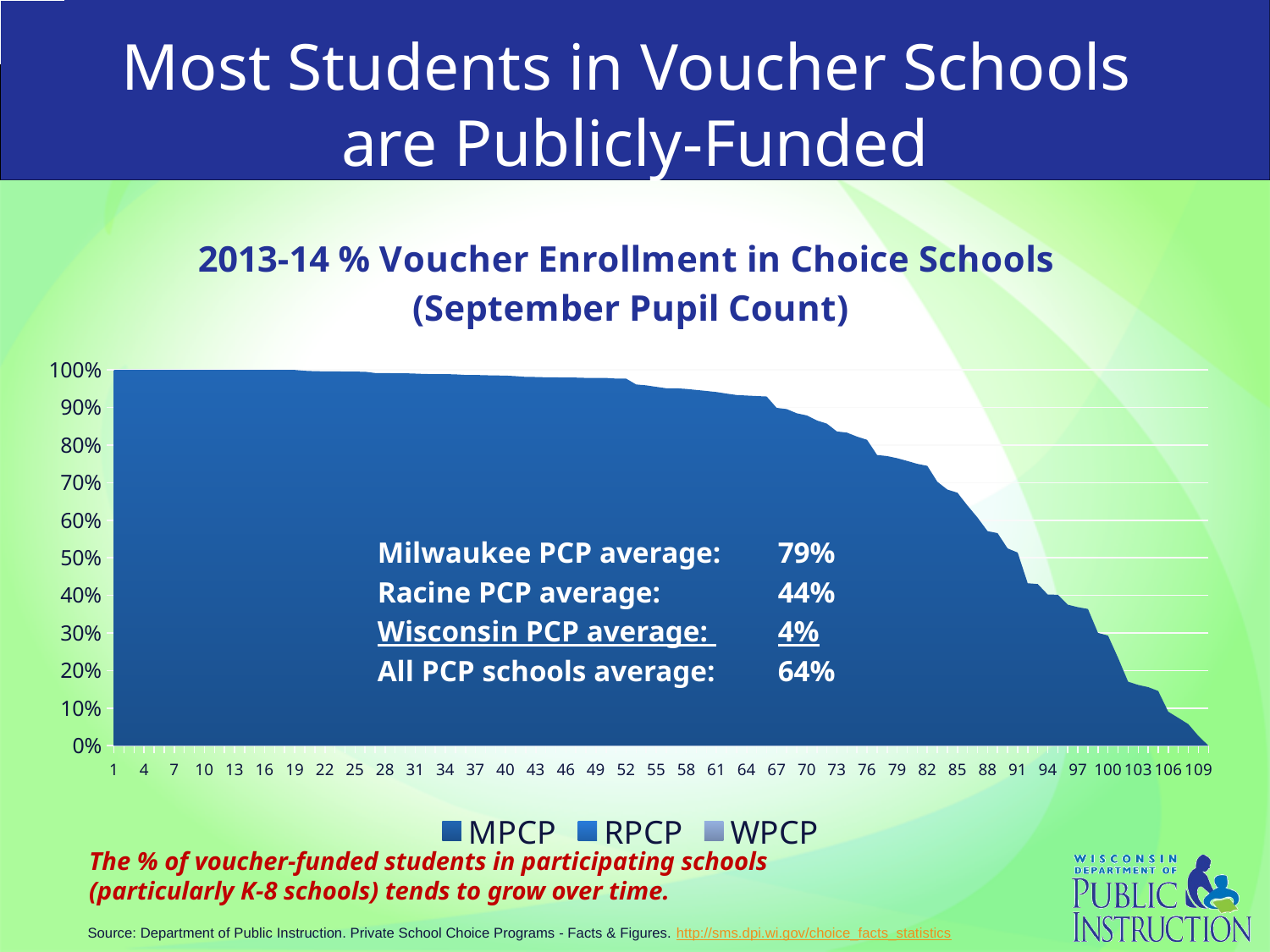
Which is larger, the Milwaukee PCP average or the Racine PCP average? Milwaukee PCP average How many series does the legend list? 3 Do the plotted values rise or fall as you move from left to right along the x axis? fall What is the Milwaukee PCP average shown on the chart? 79% What is the All PCP schools average shown on the chart? 64% What is the difference between the Milwaukee PCP average and the Racine PCP average? 35% What kind of chart is shown on the slide? area chart What is the title of the chart? 2013-14 % Voucher Enrollment in Choice Schools (September Pupil Count) What are the three series named in the legend? MPCP, RPCP, WPCP What is the Wisconsin PCP average shown on the chart? 4% What is the Racine PCP average shown on the chart? 44% Is the value for school 1 greater or less than 90%? greater